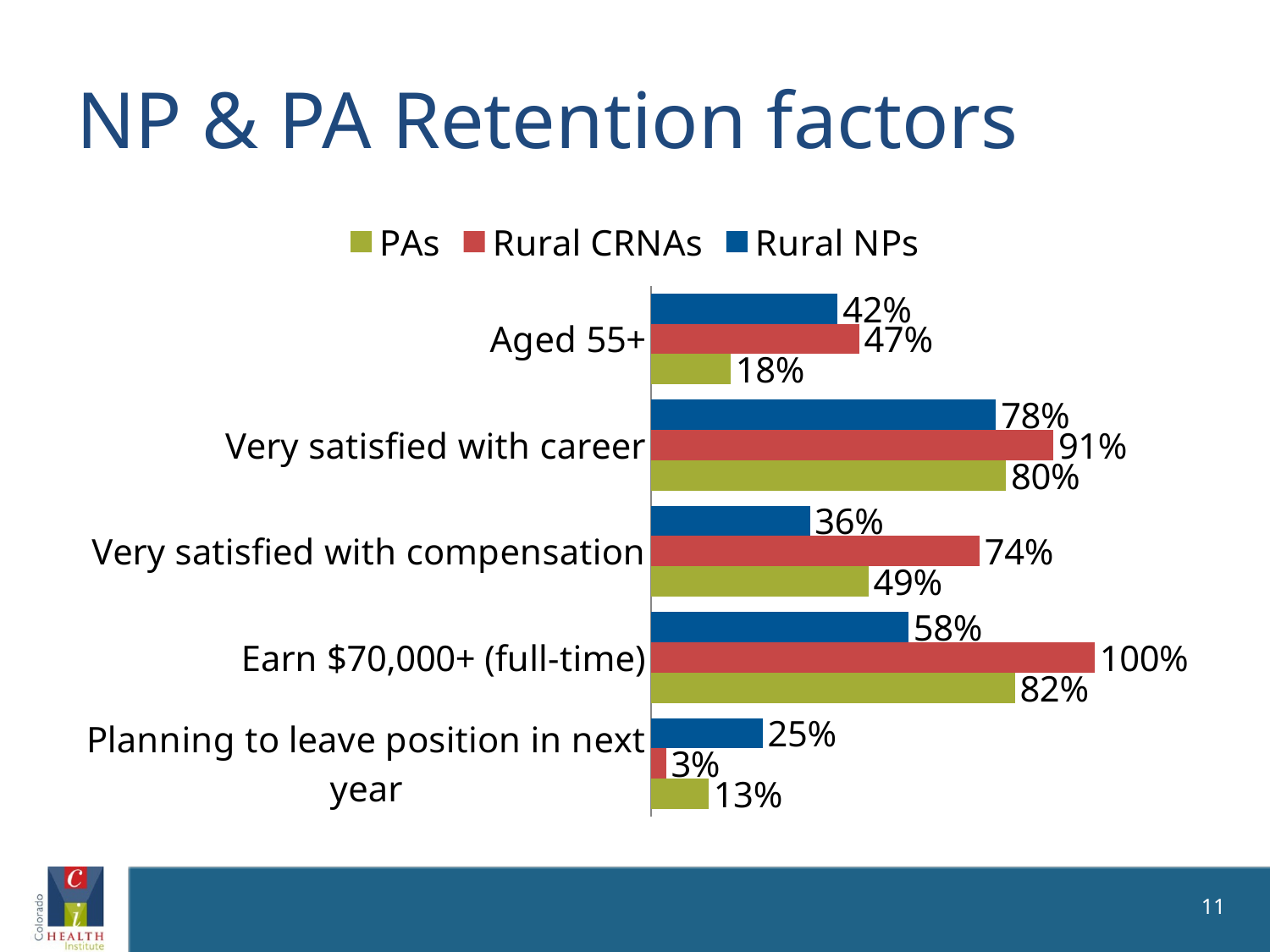
Which colour represents Rural NPs in the chart? Blue What percentage of Rural NPs are planning to leave their position in the next year? 25% What percentage of Rural CRNAs are very satisfied with compensation? 74% What percentage of PAs are aged 55+? 18% Which group has the highest percentage very satisfied with career? Rural CRNAs Which group has the lowest percentage planning to leave position in next year? Rural CRNAs How many series does the legend list? 3 Which is larger: the PAs value or the Rural NPs value for Very satisfied with compensation? PAs What kind of chart is shown on the slide? Bar chart How many retention factor categories are shown on the chart? 5 What is the difference between the Rural CRNAs and Rural NPs values for Earn $70,000+ (full-time)? 42% What percentage of Rural CRNAs earn $70,000+ (full-time)? 100%